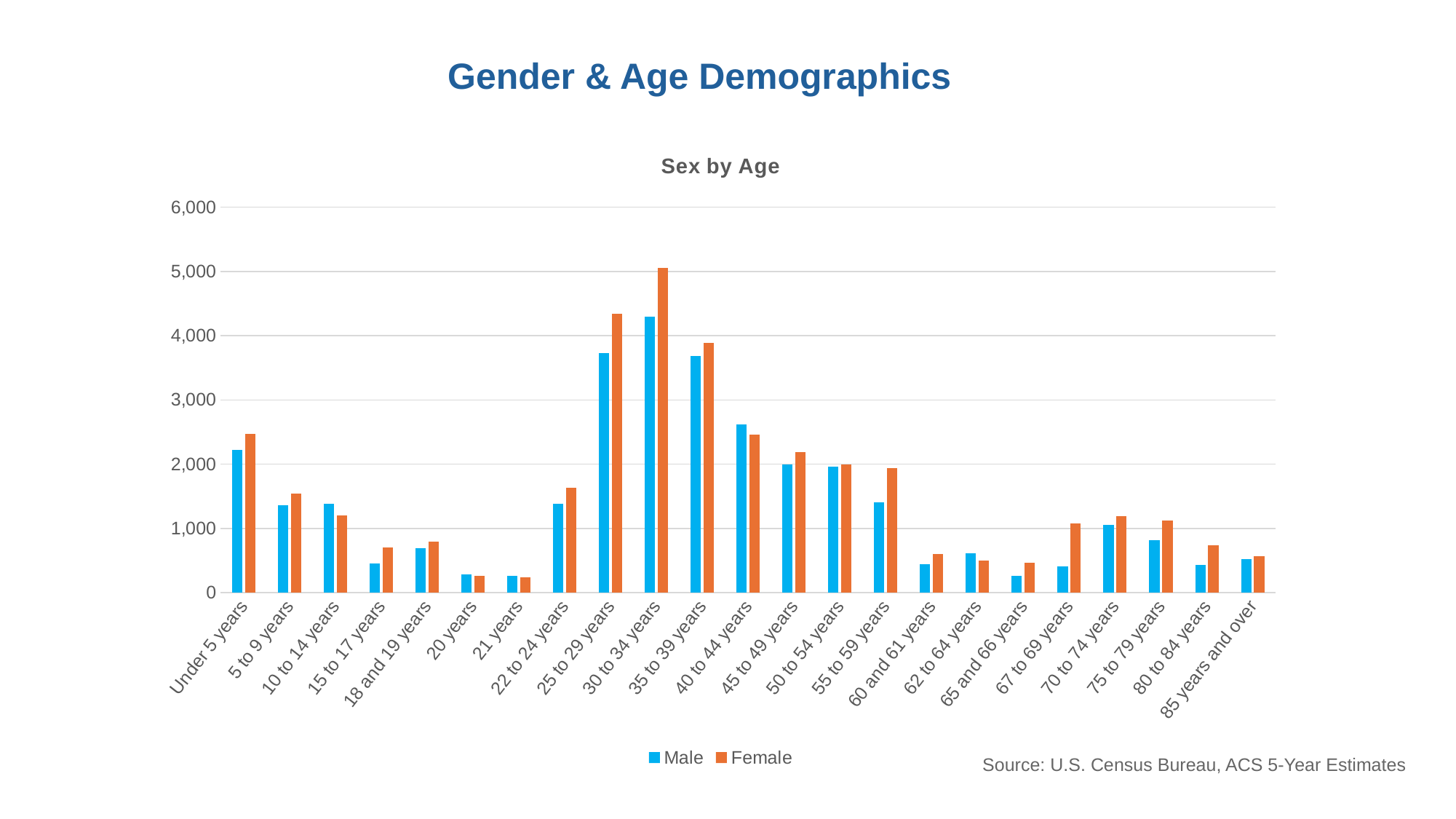
Which age category has the highest Male value? 30 to 34 years Is the Female value for 15 to 17 years greater or less than 1,000? less Is the Male value for 25 to 29 years greater or less than 3,000? greater For 55 to 59 years, which is larger, the Male or the Female value? Female Which age category has the highest Female value? 30 to 34 years Do the Male values rise or fall from 30 to 34 years through 60 and 61 years? Fall Is the Male value for 55 to 59 years greater or less than 1,000? greater For 40 to 44 years, which is larger, the Male or the Female value? Male How many age categories are shown on the x axis? 23 What kind of chart is shown on the slide? Bar chart How many series does the legend list? 2